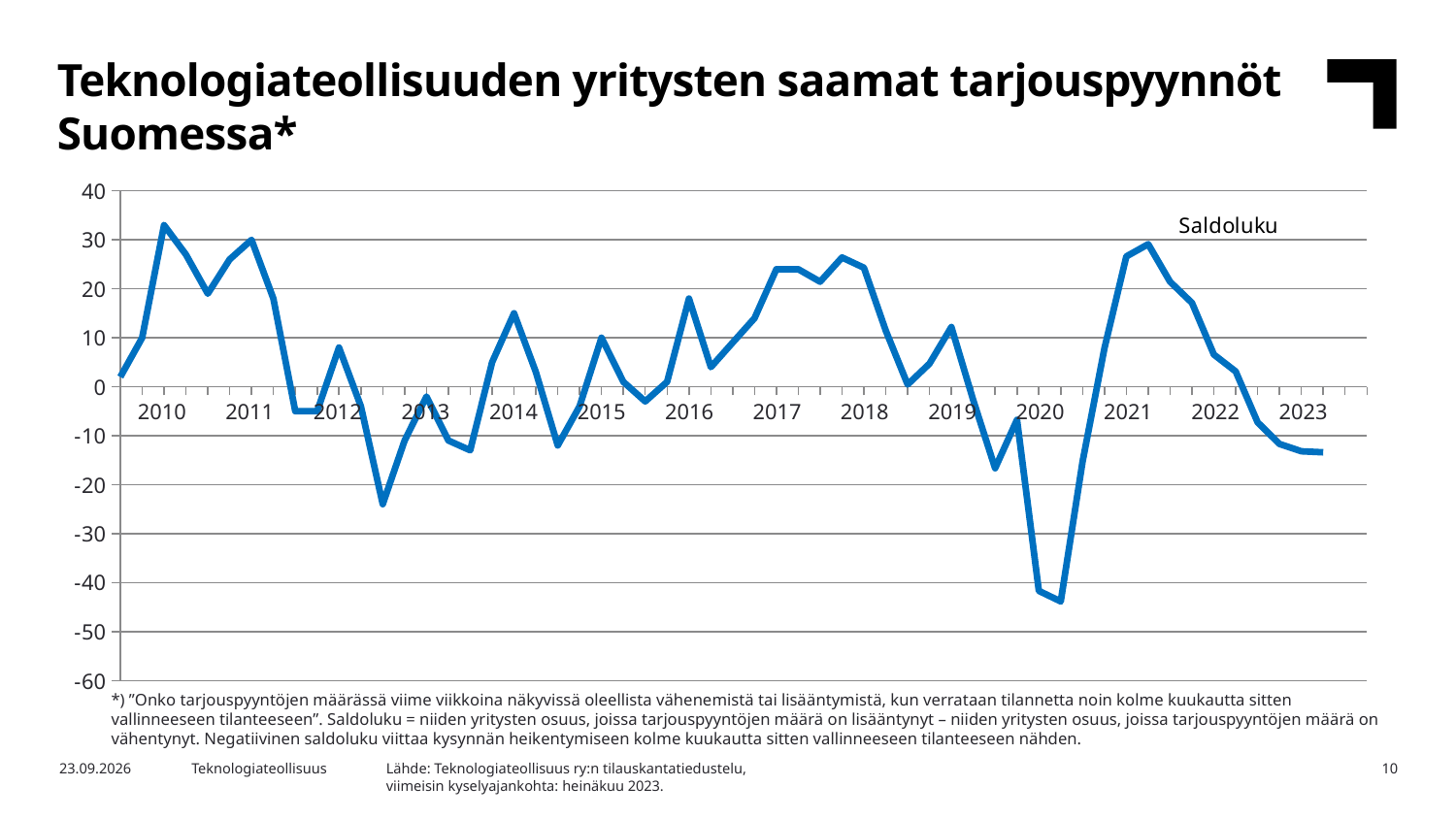
Is the peak value of the line in 2021 greater or less than 20? greater What kind of chart is shown on the slide? line chart Is the value at the end of the line in 2023 greater or less than 0? less In which year does the line reach its lowest value? 2020 Is the lowest value of the line, reached in 2020, greater or less than -30? less Which is larger: the lowest value in 2020 or the peak value in 2021? the peak value in 2021 What is the title of the chart on the slide? Teknologiateollisuuden yritysten saamat tarjouspyynnöt Suomessa* How many year labels are shown on the x axis? 14 Do the values rise or fall along the x axis from the 2021 peak to 2023? fall